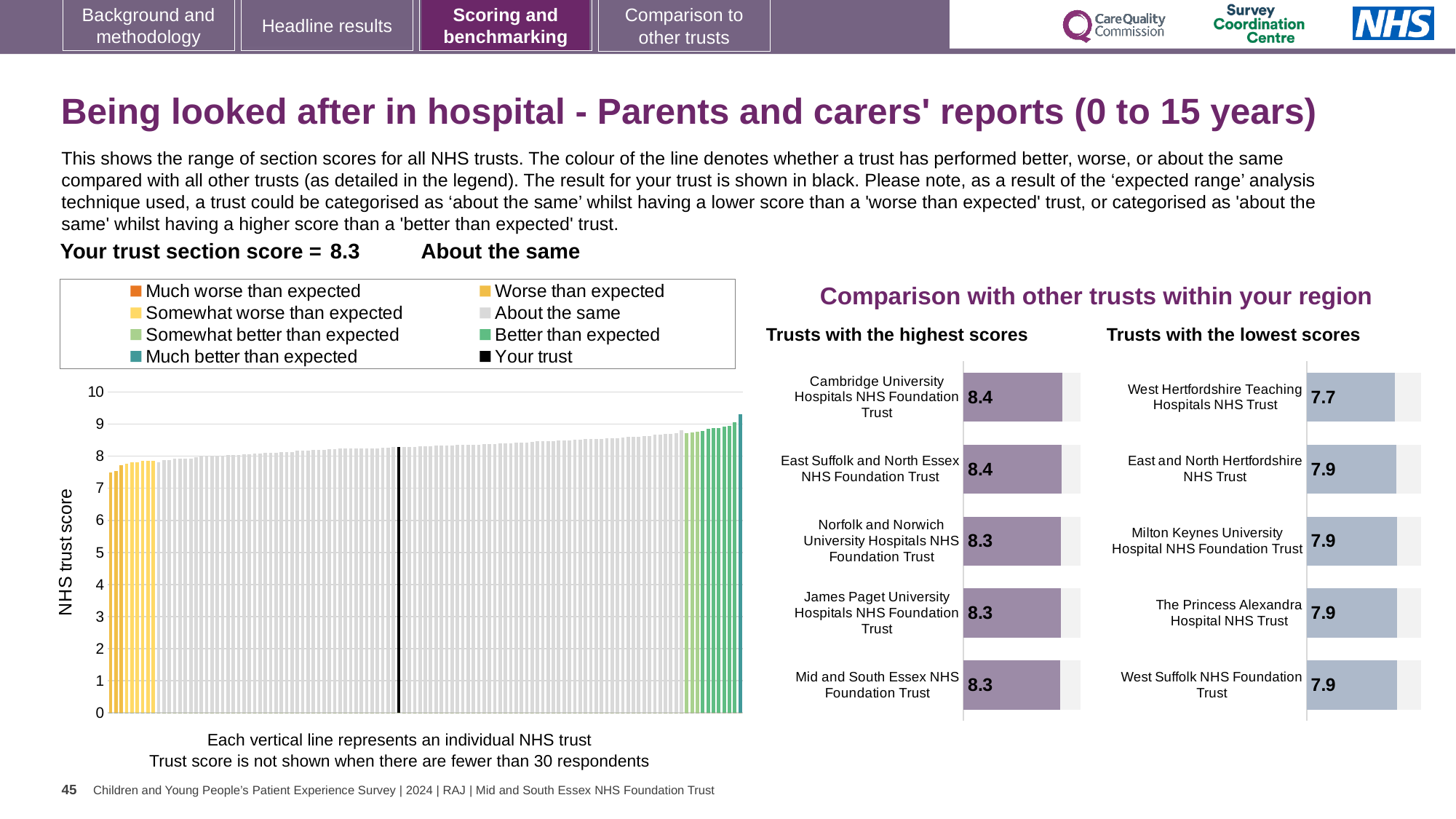
What kind of chart is the large chart on the left showing NHS trust scores? Bar chart How many trusts are shown in the 'Trusts with the highest scores' chart? 5 In the 'Trusts with the highest scores' chart, what is the score for Cambridge University Hospitals NHS Foundation Trust? 8.4 In the 'Trusts with the highest scores' chart, what is the difference between the scores of Cambridge University Hospitals NHS Foundation Trust and Mid and South Essex NHS Foundation Trust? 0.1 In the 'Trusts with the lowest scores' chart, what is the difference between the scores of West Suffolk NHS Foundation Trust and West Hertfordshire Teaching Hospitals NHS Trust? 0.2 In the 'Trusts with the lowest scores' chart, which trust has the lowest score? West Hertfordshire Teaching Hospitals NHS Trust In the large chart on the left, do the bar values rise or fall from left to right along the x axis? Rise In the 'Trusts with the lowest scores' chart, what is the score for West Hertfordshire Teaching Hospitals NHS Trust? 7.7 Which has a higher score: East Suffolk and North Essex NHS Foundation Trust in the highest scores chart, or East and North Hertfordshire NHS Trust in the lowest scores chart? East Suffolk and North Essex NHS Foundation Trust How many entries does the legend of the large chart on the left list? 8 In the large chart on the left, is the value for the black bar (Your trust) greater or less than 8? greater In the 'Trusts with the highest scores' chart, what is the score for Mid and South Essex NHS Foundation Trust? 8.3